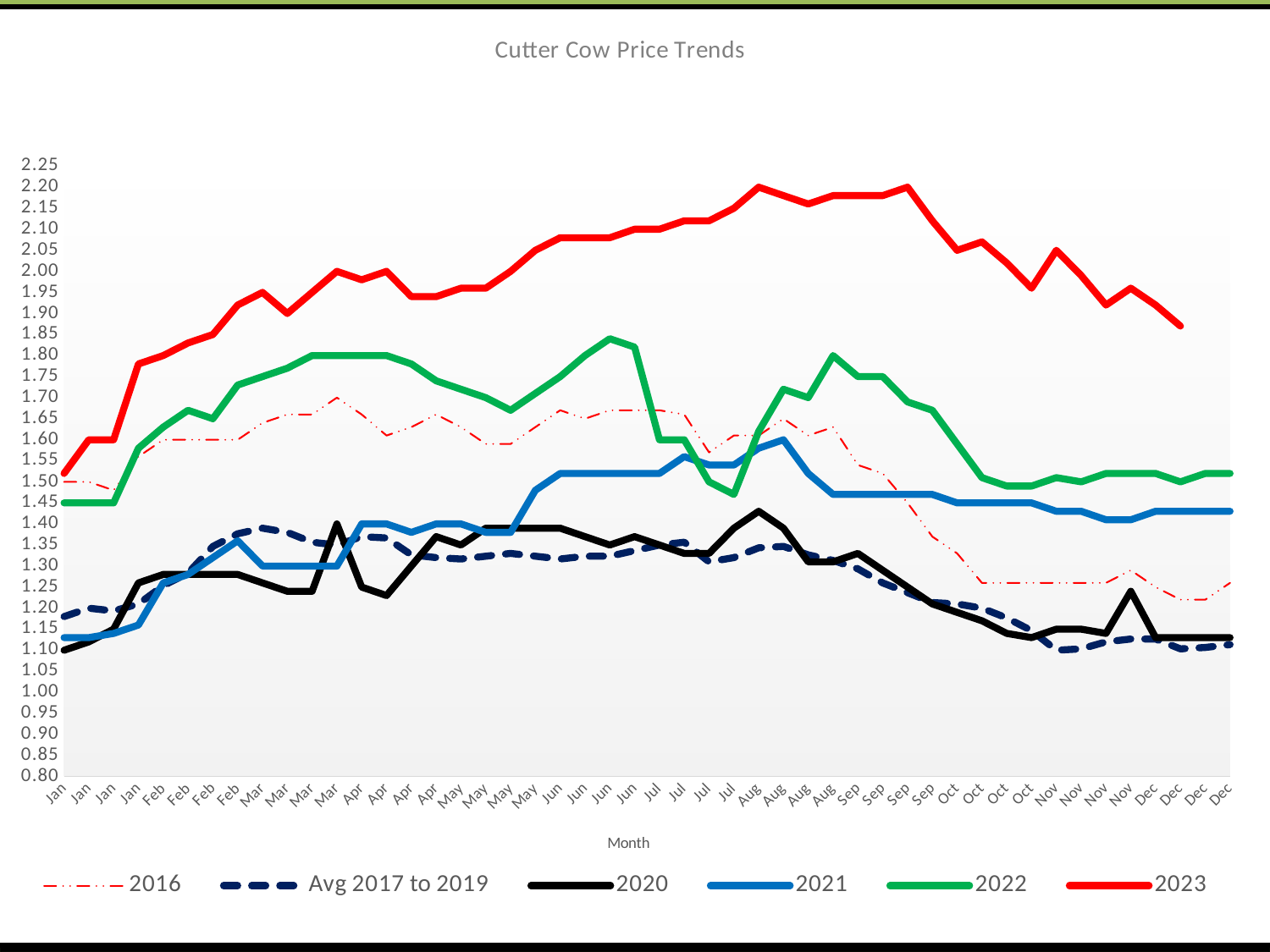
What is the label of the x axis? Month Is the peak value of the 2022 series greater or less than 1.75? greater Is the value for 2021 at the first Jan point greater or less than 1.20? less How many distinct month names appear on the x axis? 12 Is the value for 2023 at the last Dec point greater or less than 2.00? less Does the 2023 series rise or fall from its September peak to December? fall What kind of chart is shown on the slide? Line chart How many series does the legend list? 6 What is the title of the chart? Cutter Cow Price Trends At the last Dec point, which is higher: 2021 or 2020? 2021 Which series has the highest values across the chart? 2023